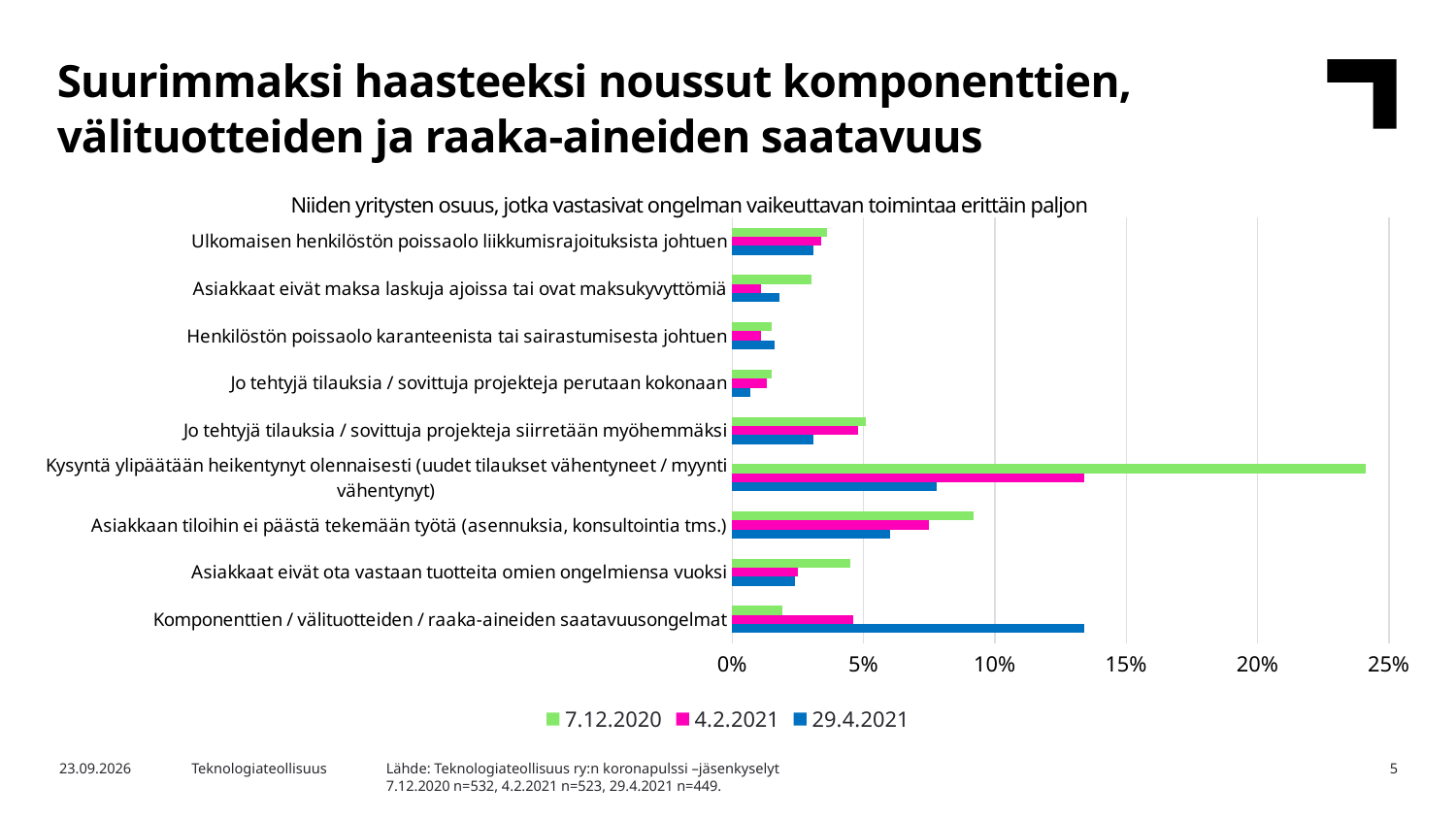
What kind of chart is shown on the slide? Bar chart Which category has the highest value for the 7.12.2020 series? Kysyntä ylipäätään heikentynyt olennaisesti (uudet tilaukset vähentyneet / myynti vähentynyt) Is the 7.12.2020 value for 'Kysyntä ylipäätään heikentynyt olennaisesti' greater or less than 20%? greater For 'Komponenttien / välituotteiden / raaka-aineiden saatavuusongelmat', which series has the larger value: 7.12.2020 or 29.4.2021? 29.4.2021 Which category has the highest value for the 29.4.2021 series? Komponenttien / välituotteiden / raaka-aineiden saatavuusongelmat How many categories (problems) are plotted on the chart? 9 How many series does the legend list? 3 For 'Kysyntä ylipäätään heikentynyt olennaisesti', which series has the larger value: 7.12.2020 or 29.4.2021? 7.12.2020 Is the 29.4.2021 value for 'Komponenttien / välituotteiden / raaka-aineiden saatavuusongelmat' greater or less than 10%? greater What are the three survey dates listed in the chart legend? 7.12.2020, 4.2.2021, 29.4.2021 Is the 7.12.2020 value for 'Asiakkaan tiloihin ei päästä tekemään työtä' greater or less than 10%? less For 'Asiakkaan tiloihin ei päästä tekemään työtä', which series has the larger value: 7.12.2020 or 29.4.2021? 7.12.2020